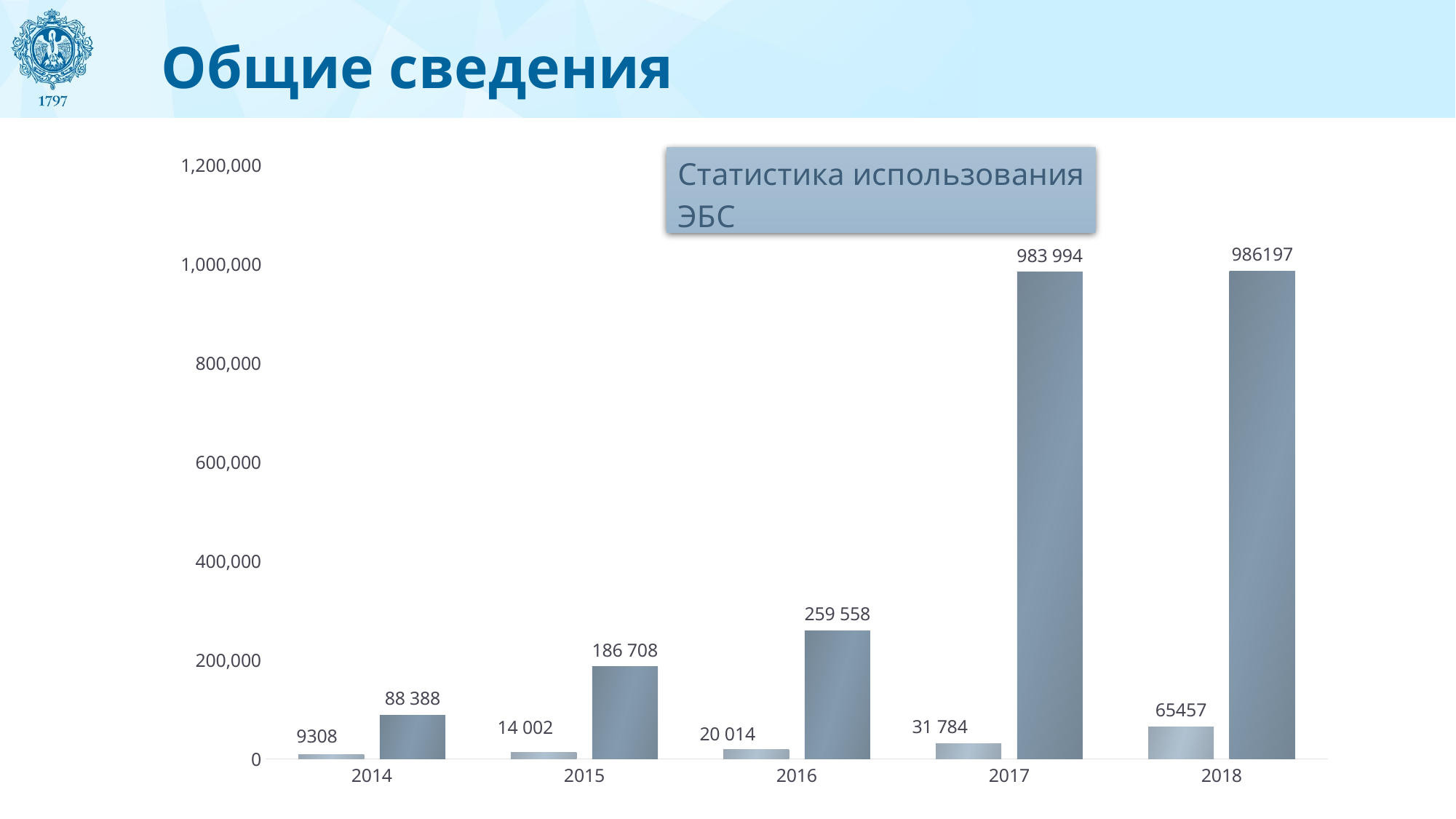
Which year has the highest value for the lighter bar? 2018 What is the value of the darker bar for 2015? 186 708 Which year has the lowest value for the darker bar? 2014 Do the darker bar values rise or fall from 2014 to 2018? rise What is the value of the lighter bar for 2018? 65457 What is the title shown in the box on the chart? Статистика использования ЭБС What is the difference between the darker bar values for 2016 and 2015? 72 850 What is the value of the darker bar for 2017? 983 994 What is the value of the lighter bar for 2014? 9308 What type of chart is shown on the slide? bar chart How many years are shown on the x axis of the chart? 5 Which is larger: the darker bar for 2016 or the darker bar for 2015? 2016